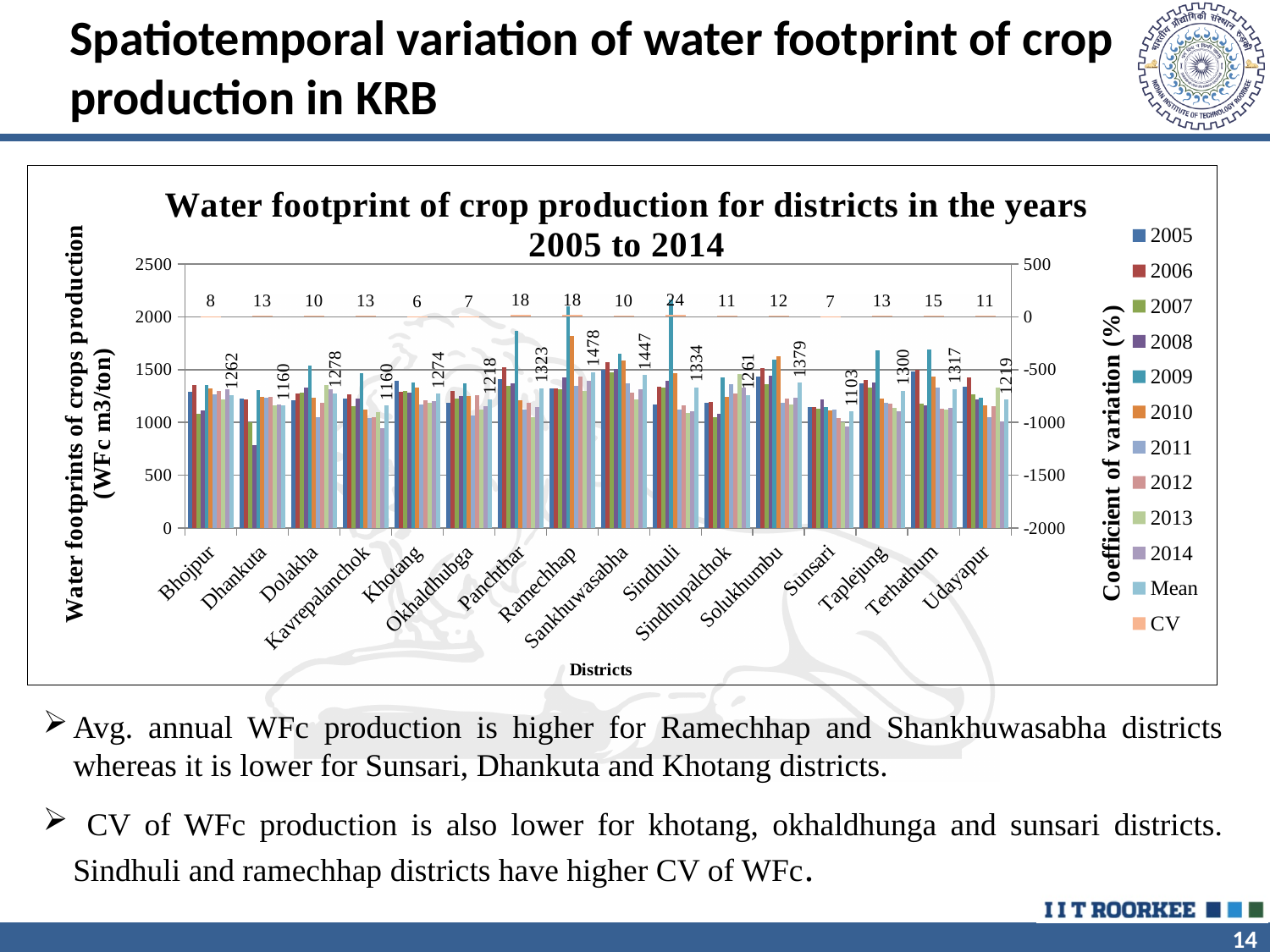
Which district has the highest labelled CV value? Sindhuli What is the difference between the labelled Mean values for Ramechhap and Sunsari? 375 How many series does the legend list? 12 What is the Mean water footprint value labelled for Sunsari? 1103 What kind of chart is shown on the slide? Bar chart Which district has the lowest labelled Mean water footprint? Sunsari Which district has the lowest labelled CV value? Khotang What is the Mean water footprint value labelled for Ramechhap? 1478 How many districts are shown on the x axis? 16 Which district has the highest labelled Mean water footprint? Ramechhap What is the CV value labelled for Sindhuli? 24 Which has the larger labelled Mean value, Solukhumbu or Taplejung? Solukhumbu